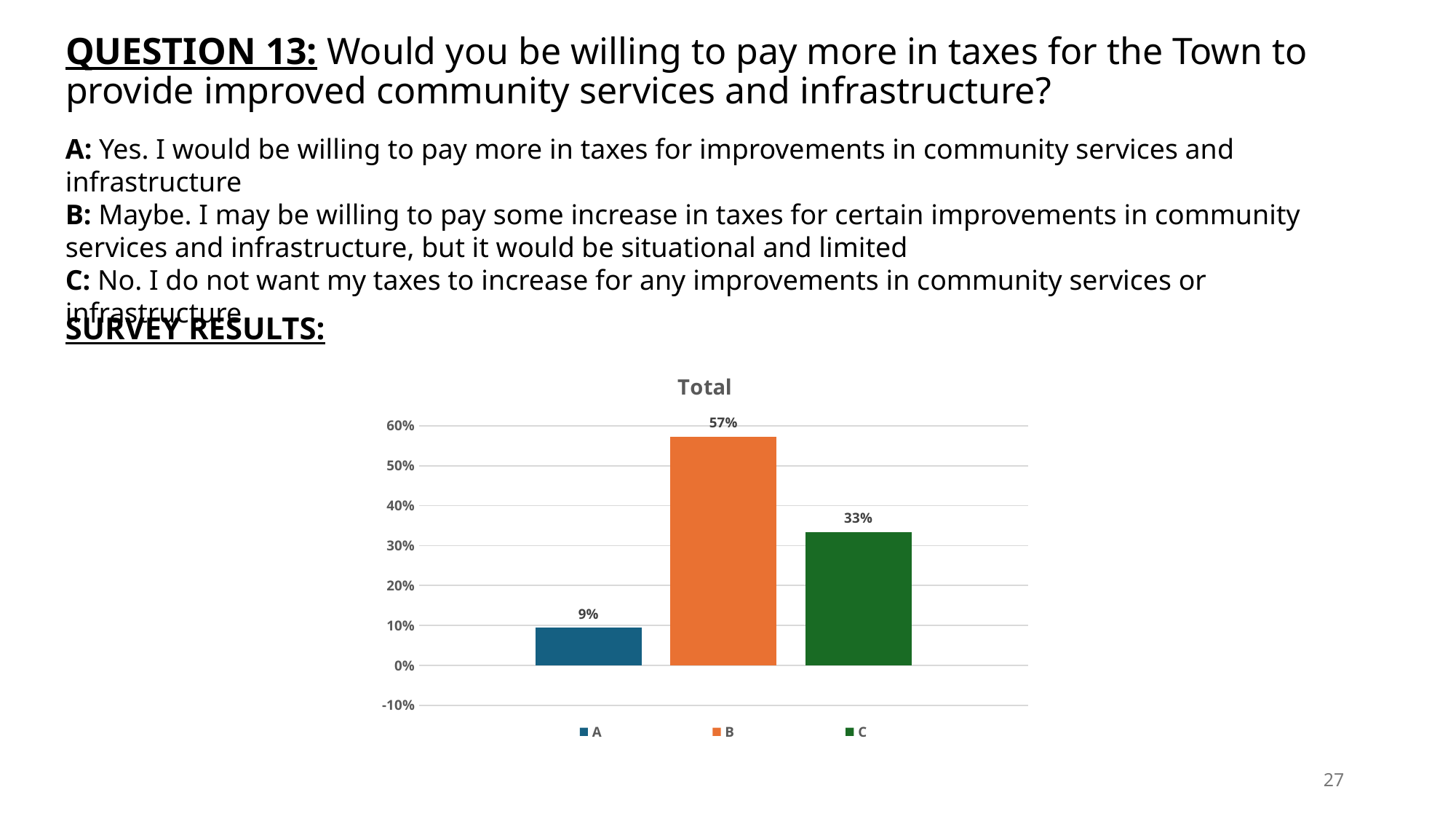
Is the value for B greater or less than 50%? greater Which option has the highest value in the chart? B What is the difference between the values for B and C? 24% What is the value for option C in the chart? 33% Which option has the lowest value in the chart? A What is the value for option A in the chart? 9% What is the title of the chart? Total What is the value for option B in the chart? 57% What is the difference between the values for C and A? 24% What kind of chart is shown on the slide? Bar chart How many bars are plotted in the chart? 3 Which is larger, the value for A or the value for C? C